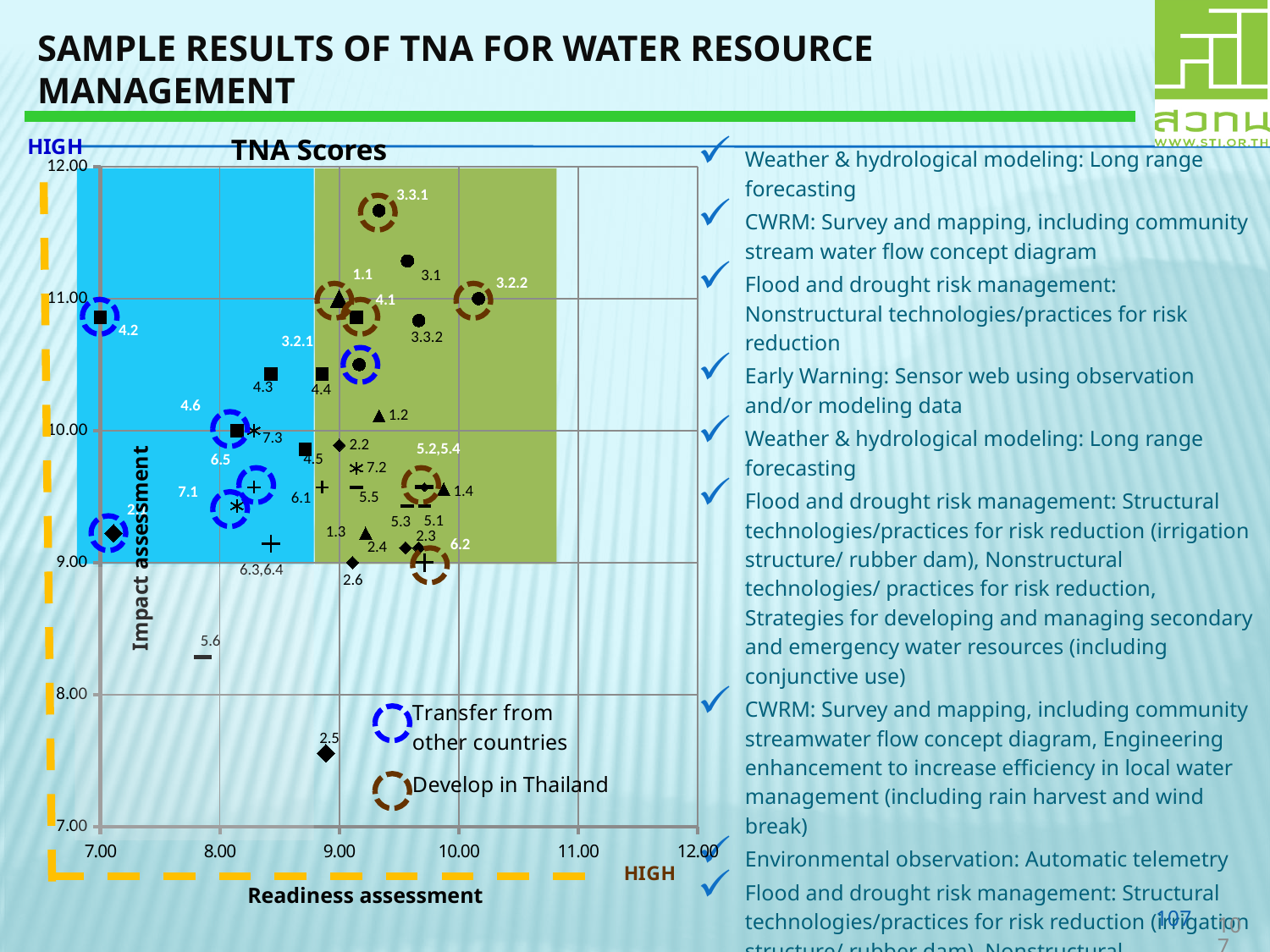
Is the Impact assessment for point 3.3.1 greater or less than 11.00? greater Is the Impact assessment for point 2.5 greater or less than 8.00? less What is the title of the chart on the slide? TNA Scores Is the Readiness assessment for point 4.2 greater or less than 8.00? less How many entries does the legend of the TNA Scores chart list? 2 Which point has the highest Impact assessment in the TNA Scores chart? 3.3.1 What is the label of the vertical axis of the TNA Scores chart? Impact assessment Which point has the highest Readiness assessment in the TNA Scores chart? 3.2.2 Which point has a higher Readiness assessment, 4.2 or 3.2.2? 3.2.2 Which point has the lowest Impact assessment in the TNA Scores chart? 2.5 What kind of chart is the TNA Scores chart? scatter chart